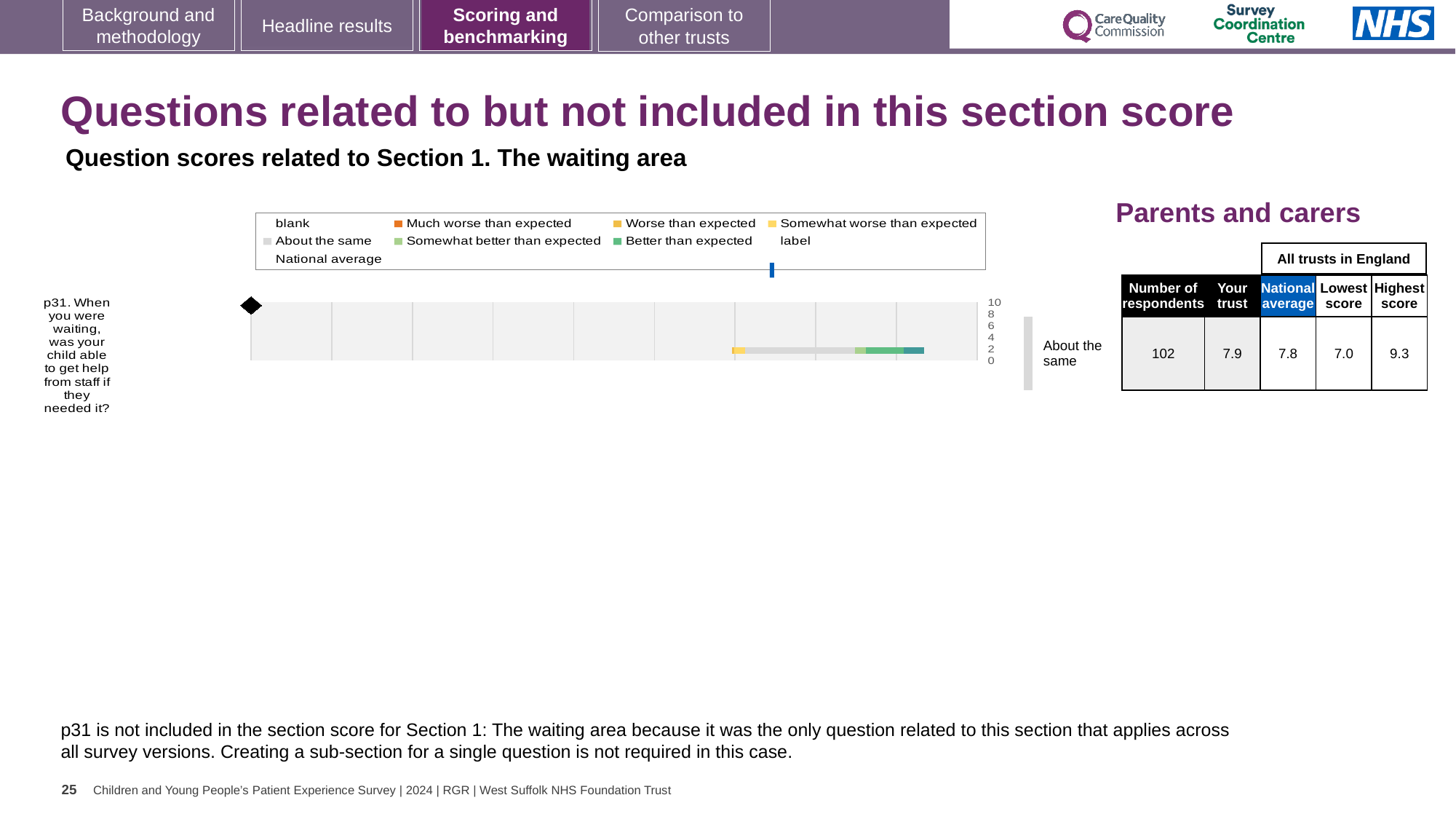
What kind of chart is shown on the slide for question p31? bar chart In the table beside the chart, what is the highest score among all trusts in England for p31? 9.3 In the table beside the chart, what is the national average score for p31? 7.8 How many entries does the chart legend list? 9 Which question is plotted in the chart? p31. When you were waiting, was your child able to get help from staff if they needed it? In the table beside the chart, what is the number of respondents for p31? 102 In the table beside the chart, what is the 'Your trust' score for p31? 7.9 In the table beside the chart, what is the lowest score among all trusts in England for p31? 7.0 How many questions (categories) are plotted in the chart? 1 What benchmark category label is shown to the right of the bar for p31? About the same In the table beside the chart, what is the difference between the highest score and the lowest score for p31? 2.3 In the table beside the chart, which is larger for p31: the 'Your trust' score or the national average? Your trust